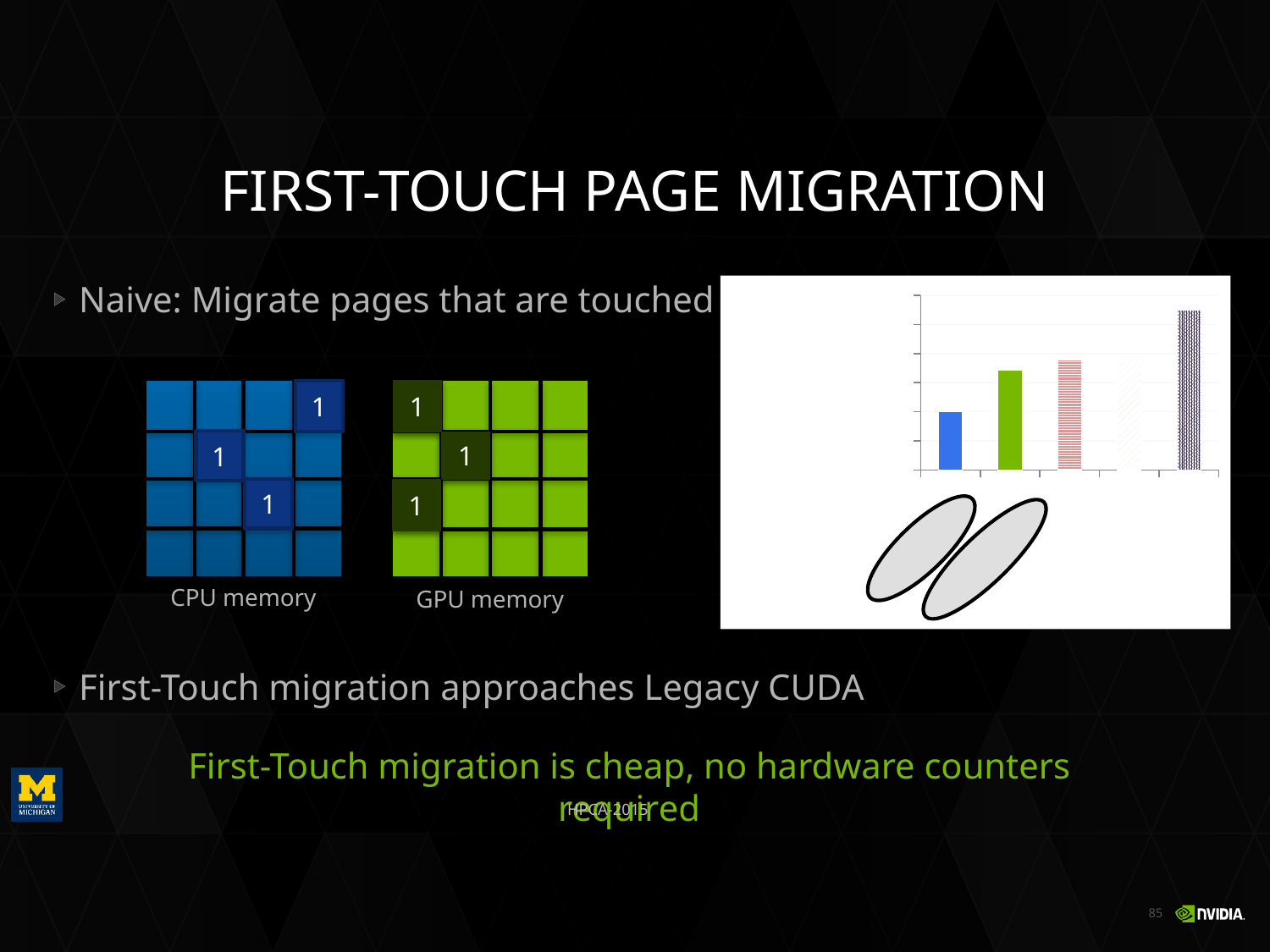
In the chart on the right side of the slide, which bar is the shortest? the leftmost (blue) bar In the chart on the right side of the slide, do the bar heights generally rise or fall from left to right? rise In the chart on the right side of the slide, which is taller, the green bar or the rightmost striped bar? the rightmost striped bar What kind of chart is shown on the right side of the slide? bar chart What colour is the leftmost bar in the chart on the right side of the slide? blue Does the chart on the right side of the slide show a legend? no How many bars are plotted in the chart on the right side of the slide? 5 In the chart on the right side of the slide, which is taller, the blue bar or the green bar? the green bar In the chart on the right side of the slide, which bar is the tallest? the rightmost (dark striped) bar